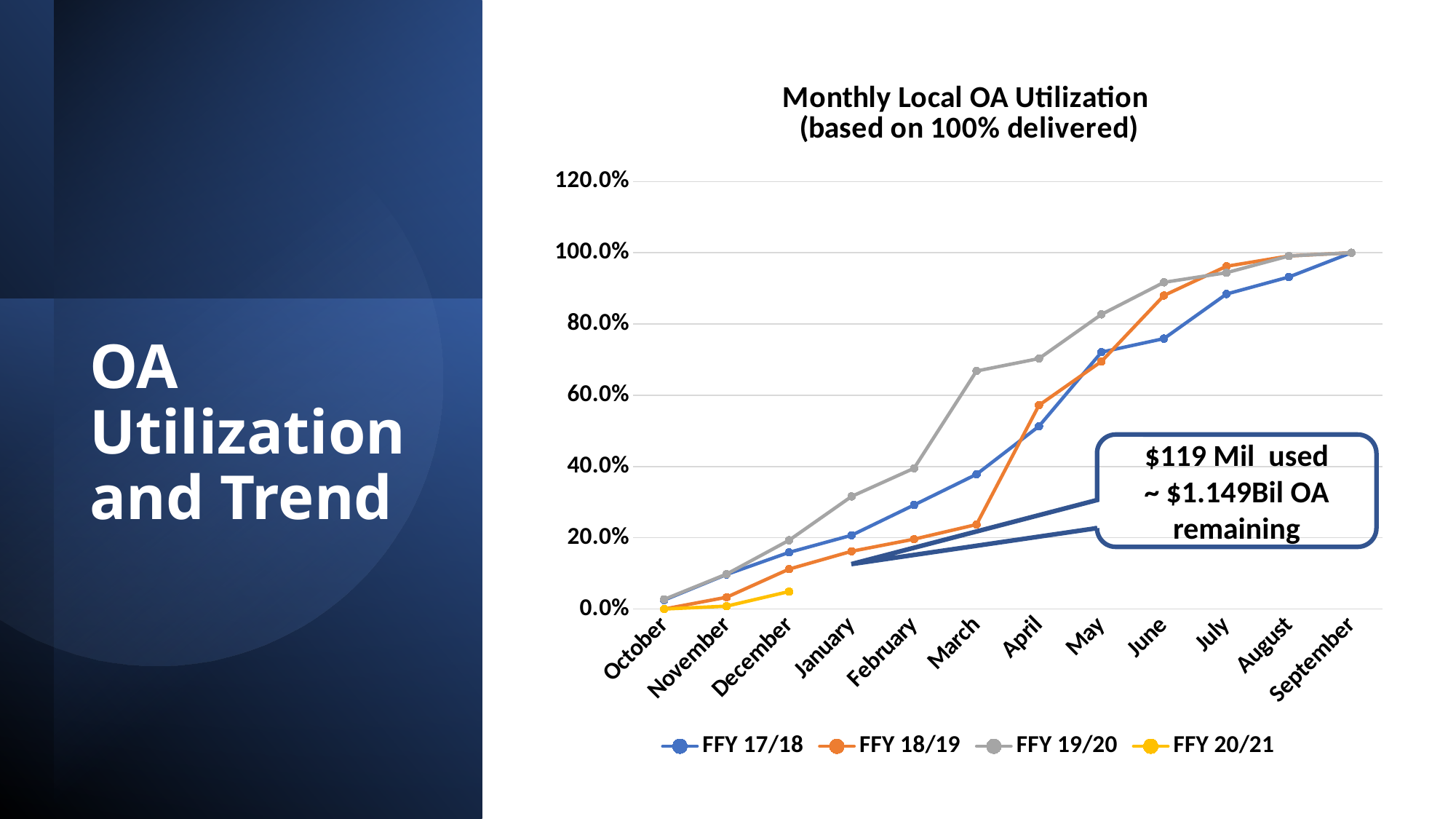
Do the FFY 17/18 values rise or fall from October to September? Rise What type of chart is shown on the slide? Line chart How many months are shown along the x axis? 12 What value does the FFY 19/20 series reach in September? 100.0% What is the title of the chart? Monthly Local OA Utilization (based on 100% delivered) How many series does the legend list? 4 Which series has the highest value in March? FFY 19/20 Is the value for FFY 17/18 in June greater or less than 80.0%? less Which series has the lowest value in March? FFY 18/19 In January, which is higher: FFY 19/20 or FFY 17/18? FFY 19/20 Is the value for FFY 19/20 in March greater or less than 60.0%? greater What does the callout box on the chart say? $119 Mil used ~ $1.149Bil OA remaining